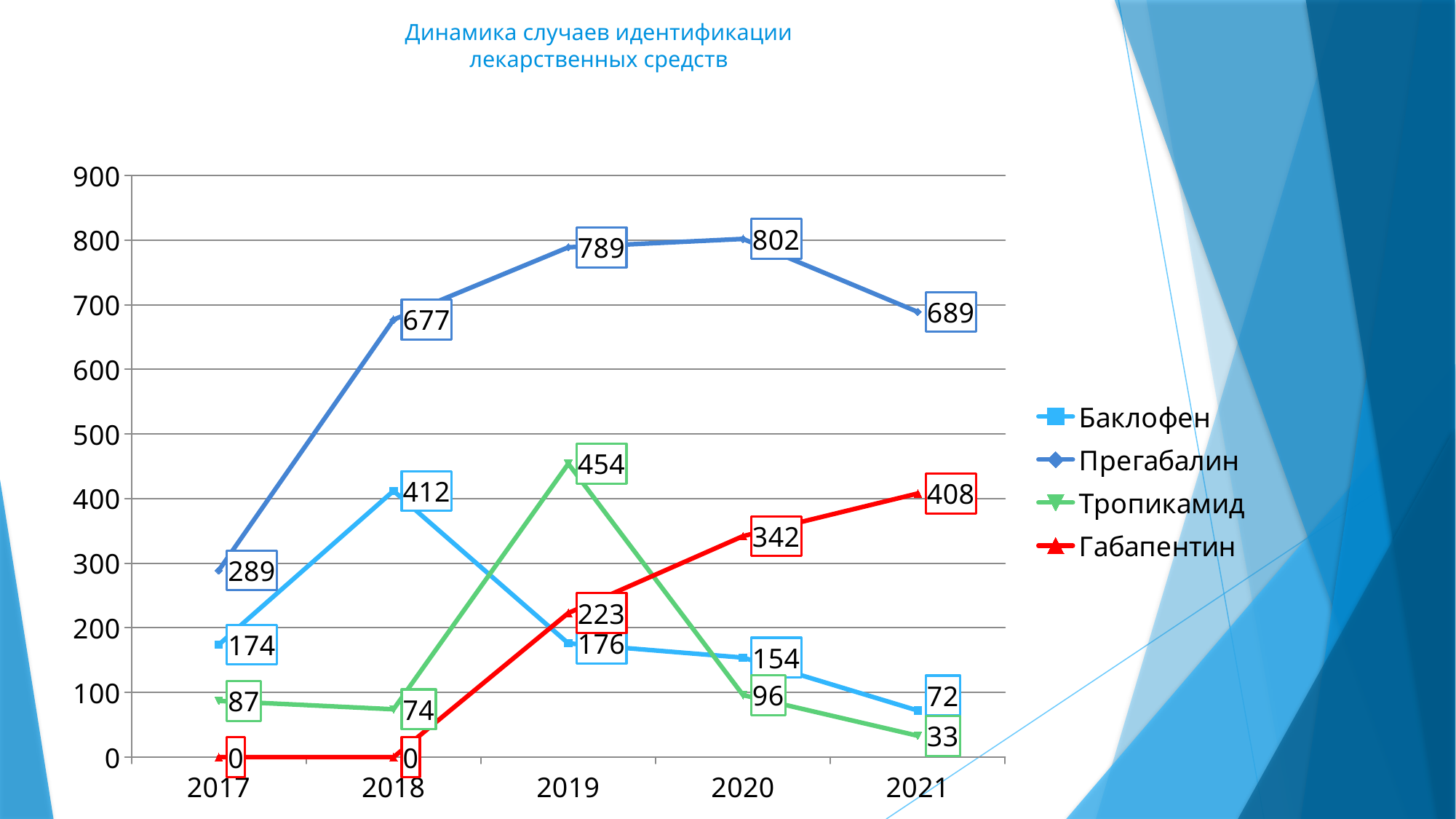
Does the value for Габапентин rise or fall from 2018 to 2021? rise What is the value for Прегабалин in 2020? 802 What is the value for Габапентин in 2017? 0 What type of chart is shown on the slide? line chart What is the difference between the Прегабалин values in 2020 and 2021? 113 In which year is the value for Баклофен highest? 2018 How many series does the legend list? 4 What is the title of the chart? Динамика случаев идентификации лекарственных средств What is the value for Тропикамид in 2019? 454 In which year is the value for Тропикамид lowest? 2021 Which is larger in 2021: the value for Габапентин or the value for Баклофен? Габапентин How many years are shown on the x axis? 5